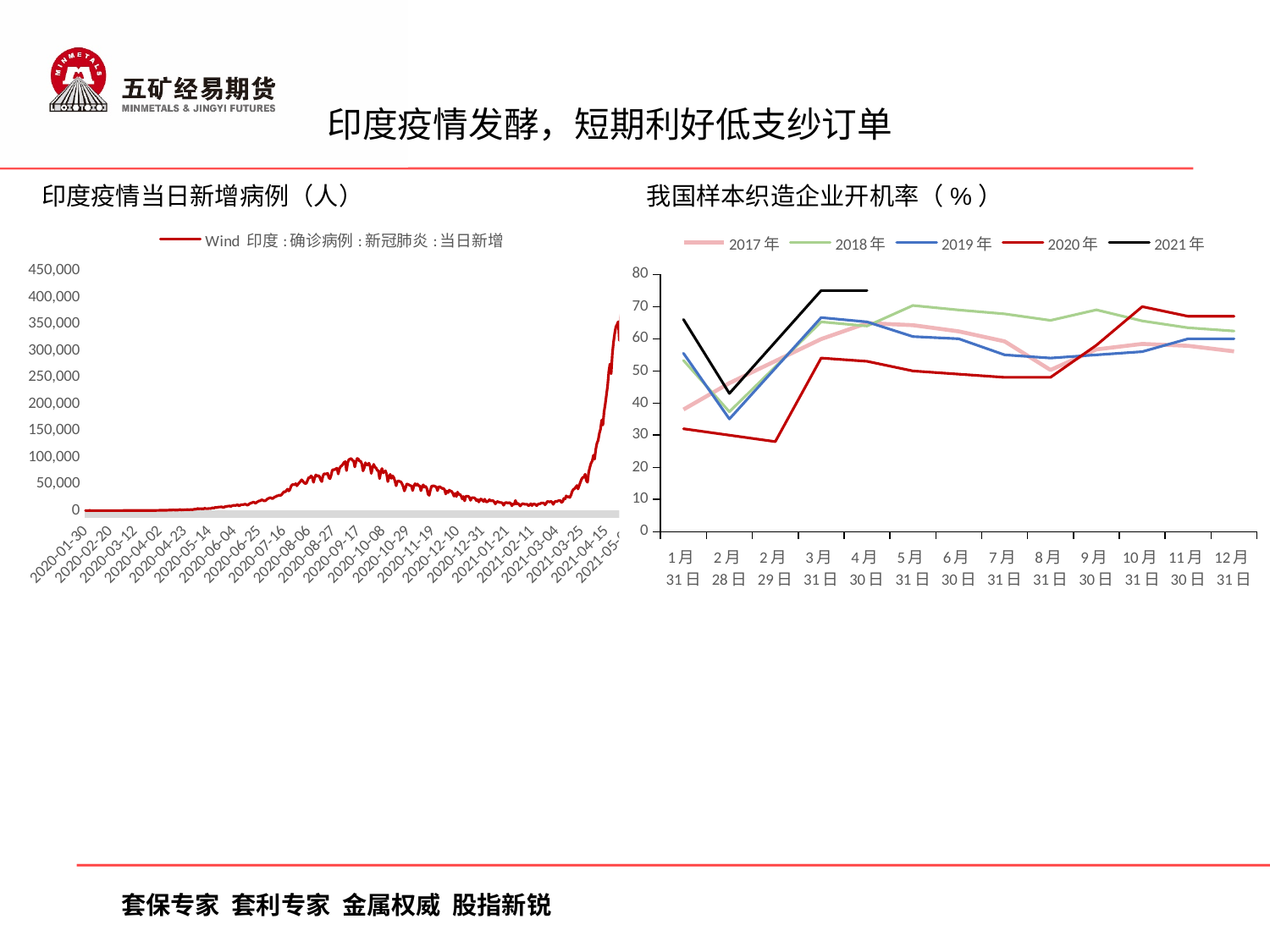
How many x-axis date categories are shown on the right chart 我国样本织造企业开机率（%）? 13 How many series does the legend of the right chart 我国样本织造企业开机率（%） list? 5 In the right chart 我国样本织造企业开机率（%）, is the 2021年 value at 4月30日 greater or less than 70? greater What type of chart is the left chart titled 印度疫情当日新增病例（人）? line chart In the right chart 我国样本织造企业开机率（%）, does the 2021年 line rise or fall from 2月28日 to 3月31日? rise In the right chart 我国样本织造企业开机率（%）, is the 2020年 value at 2月29日 greater or less than 30? less In the right chart 我国样本织造企业开机率（%）, which is larger at 10月31日: the 2020年 value or the 2017年 value? 2020年 What is the legend entry of the single series in the left chart 印度疫情当日新增病例（人）? Wind 印度:确诊病例:新冠肺炎:当日新增 In the right chart 我国样本织造企业开机率（%）, which series has the lowest value at 2月29日? 2020年 In the right chart 我国样本织造企业开机率（%）, which series has the highest value at 3月31日? 2021年 In the left chart 印度疫情当日新增病例（人）, is the value at the end of the series (2021-05) greater or less than 300,000? greater